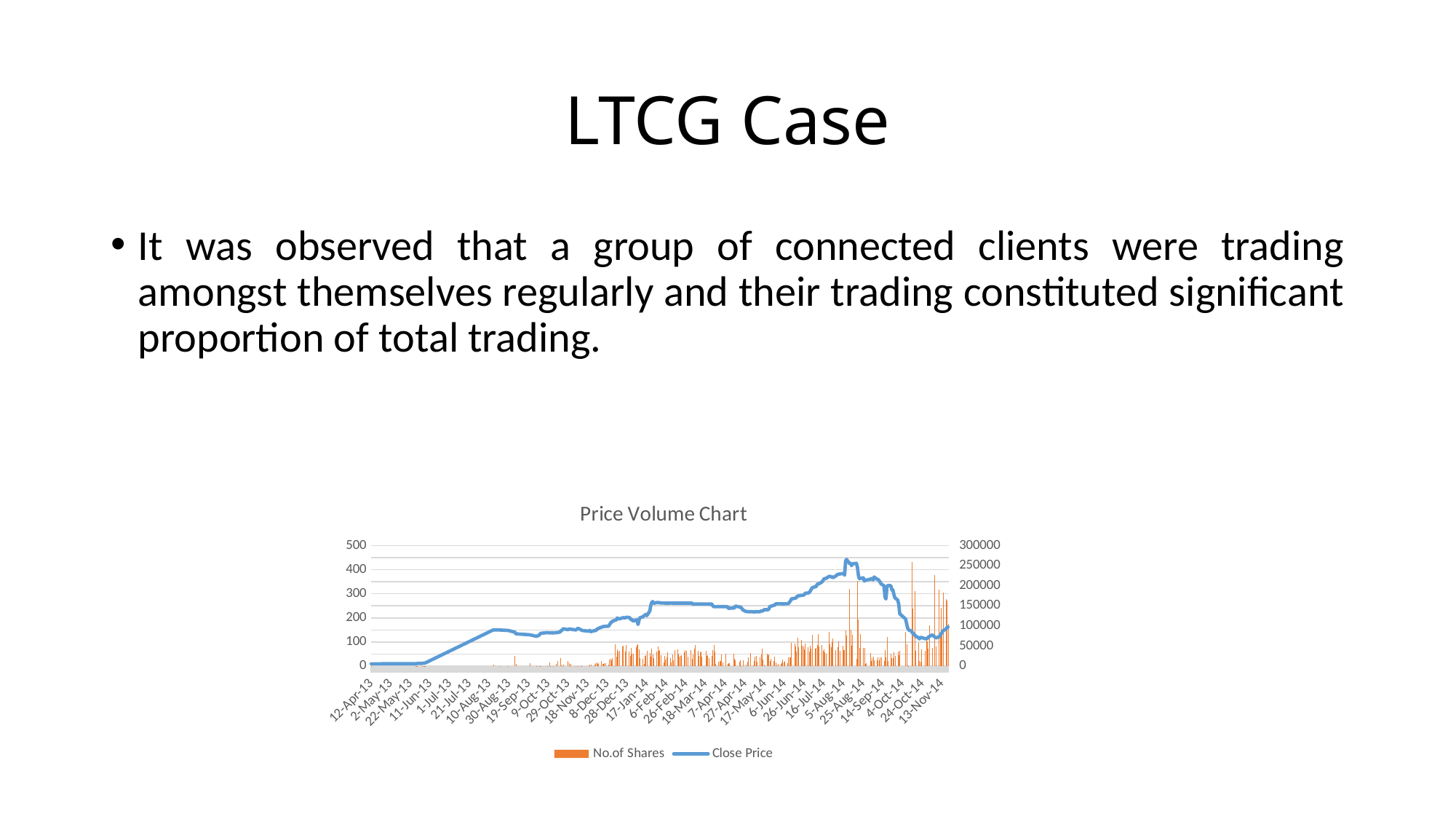
Does the Close Price rise or fall between 5-Aug-14 and 24-Oct-14? fall Is the Close Price around 24-Oct-14 greater or less than 200? less Around which x-axis date does the Close Price reach its highest point? 5-Aug-14 What is the highest value shown on the right-hand axis of the chart? 300000 How many series does the chart's legend list? 2 Is the Close Price around 6-Feb-14 greater or less than 200? greater Which series in the chart is drawn as a line? Close Price Does the Close Price generally rise or fall between 12-Apr-13 and 5-Aug-14? rise Is the Close Price at 12-Apr-13 greater or less than 100? less What is the title of the chart on the slide? Price Volume Chart Is the Close Price around 6-Feb-14 higher or lower than around 1-Jul-13? higher